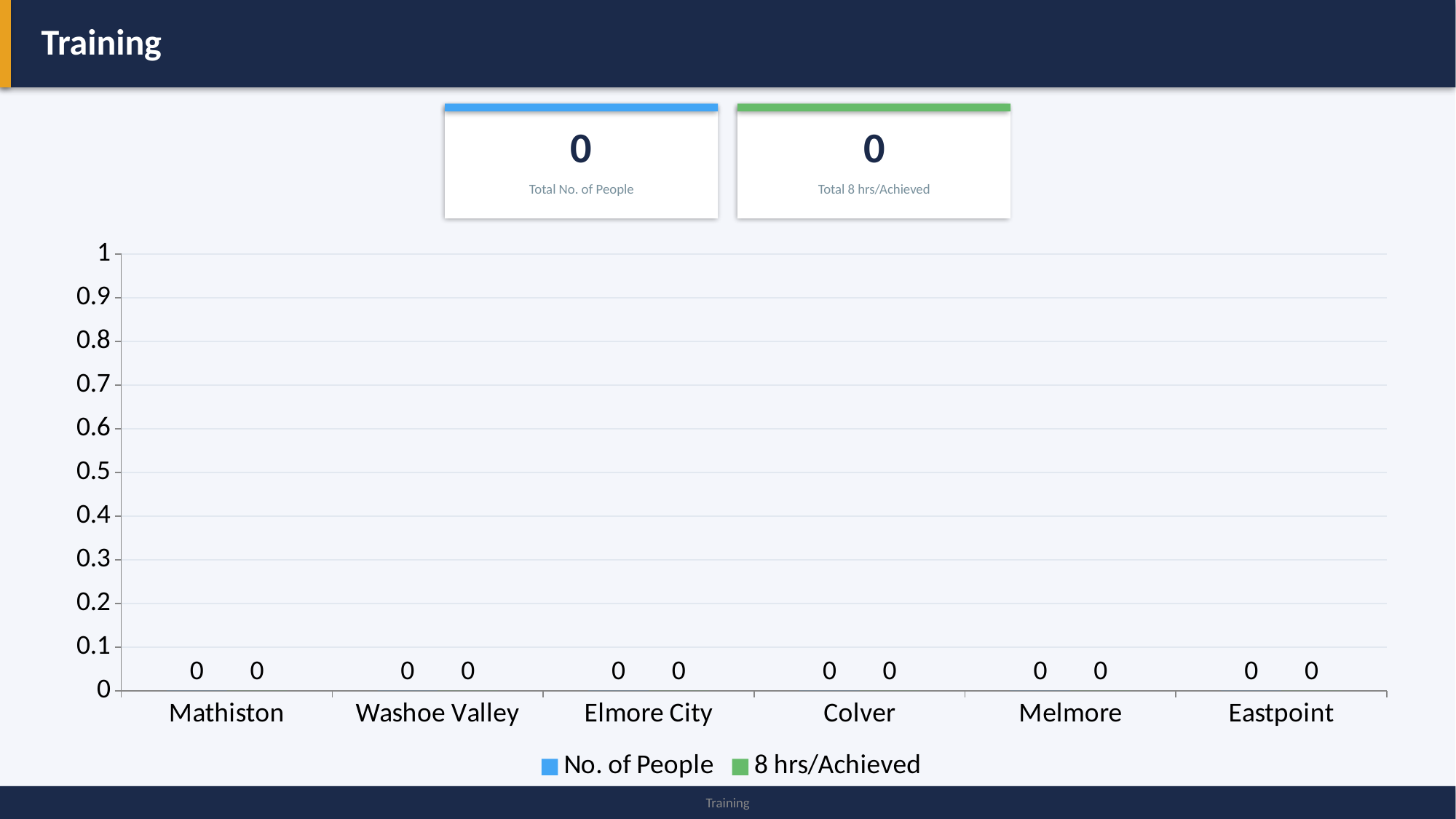
What kind of chart is shown on the slide? bar chart What is the value shown in the Total 8 hrs/Achieved card above the chart? 0 How many categories are shown on the x axis of the chart? 6 What is the value of No. of People for Mathiston? 0 What is the value of No. of People for Eastpoint? 0 What is the value of 8 hrs/Achieved for Colver? 0 How many series does the chart legend list? 2 What is the value of No. of People for Melmore? 0 What are the two series named in the chart legend? No. of People and 8 hrs/Achieved What is the highest value shown on the chart's y axis? 1 What is the difference between No. of People and 8 hrs/Achieved for Elmore City? 0 What is the value of 8 hrs/Achieved for Washoe Valley? 0